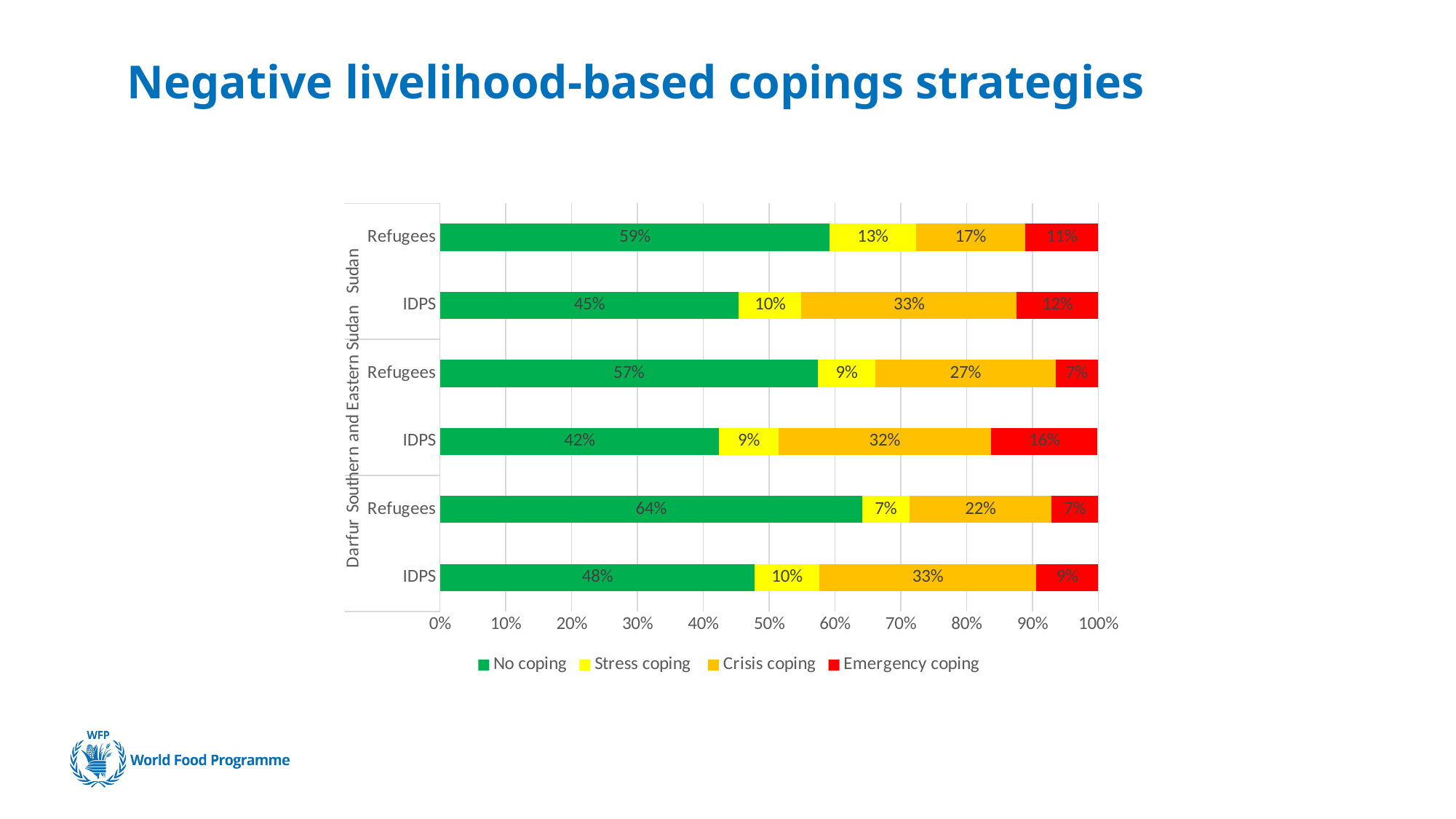
What is the difference between the no coping values for Sudan refugees and Sudan IDPS? 14% What is the crisis coping value for IDPS in Sudan? 33% What is the stress coping value for refugees in Sudan? 13% Which is larger: the crisis coping value for Darfur refugees or for Darfur IDPS? Darfur IDPS Which group has the highest no coping share? Darfur Refugees Which colour represents emergency coping in the legend? Red What type of chart is shown? Stacked bar chart Which group has the lowest no coping share? Southern and Eastern Sudan IDPS What percentage of Darfur refugees report no coping? 64% How many bars are shown in the chart? 6 What is the emergency coping value for IDPS in Southern and Eastern Sudan? 16% How many series does the legend list? 4